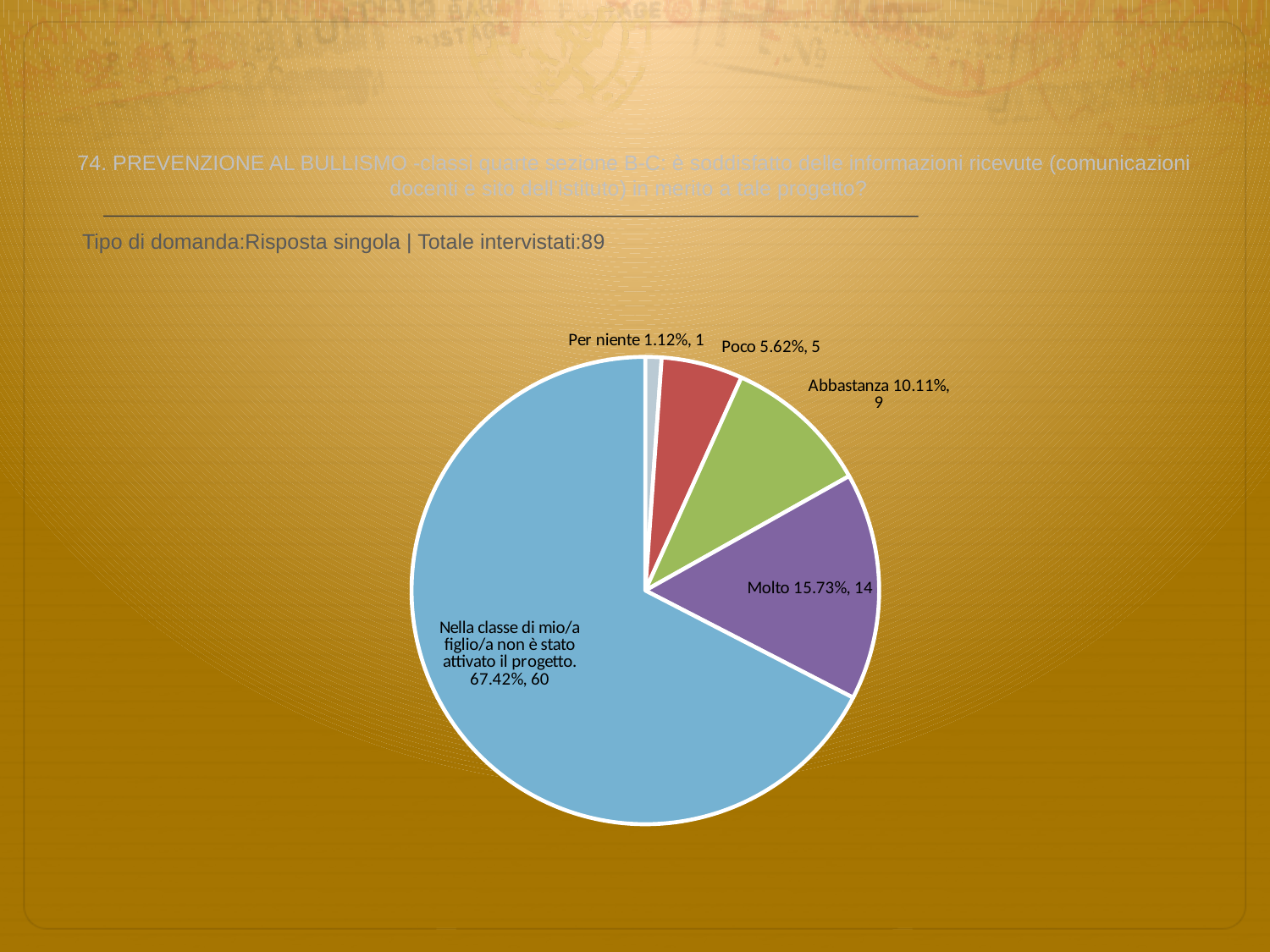
How many slices does the pie chart have? 5 What is the total number of respondents shown on the slide? 89 How many respondents answered 'Abbastanza'? 9 Which category has the smallest slice of the pie? Per niente What is the difference in count between 'Molto' and 'Abbastanza'? 5 What kind of chart is shown on the slide? pie chart What colour is the 'Molto' slice? purple What percentage share does the 'Per niente' slice have? 1.12% What percentage share does the 'Molto' slice have? 15.73% Which has more respondents, 'Poco' or 'Molto'? Molto Which category has the largest slice of the pie? Nella classe di mio/a figlio/a non è stato attivato il progetto. How many respondents answered 'Poco'? 5